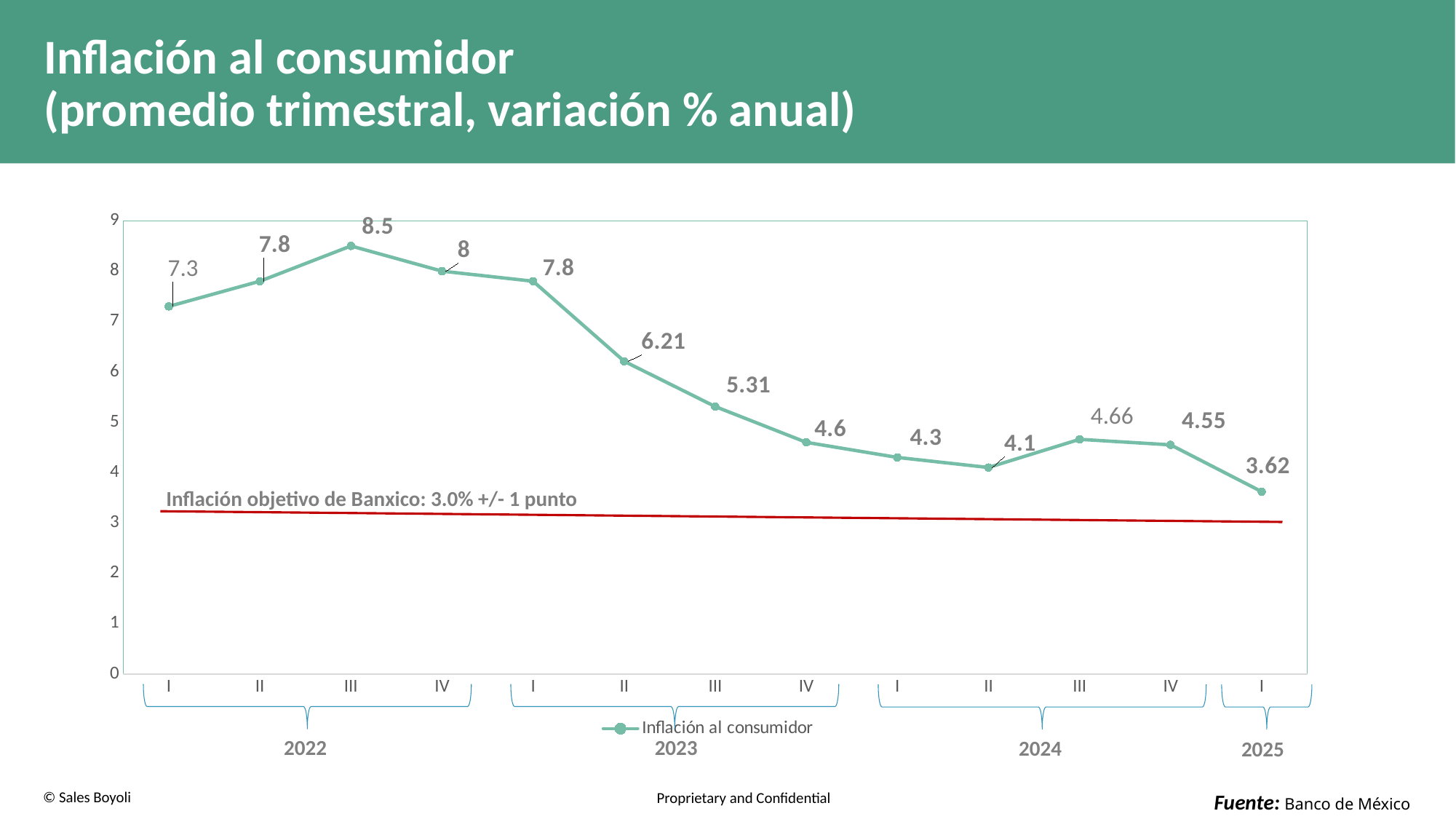
Which is larger, the value for quarter III of 2024 or quarter IV of 2024? III 2024 What is the value for quarter II of 2023? 6.21 Is the value for quarter IV of 2023 greater or less than 5? less Which quarter has the lowest inflation value? I 2025 What kind of chart is shown on the slide? line chart What is the value for quarter I of 2025? 3.62 Do the values generally rise or fall from quarter I of 2023 to quarter I of 2025? fall How many quarterly data points are plotted on the chart? 13 What is the difference between the values for quarter III of 2022 and quarter I of 2025? 4.88 What is the value for quarter III of 2022? 8.5 How many series does the legend list? 1 Which quarter has the highest inflation value? III 2022